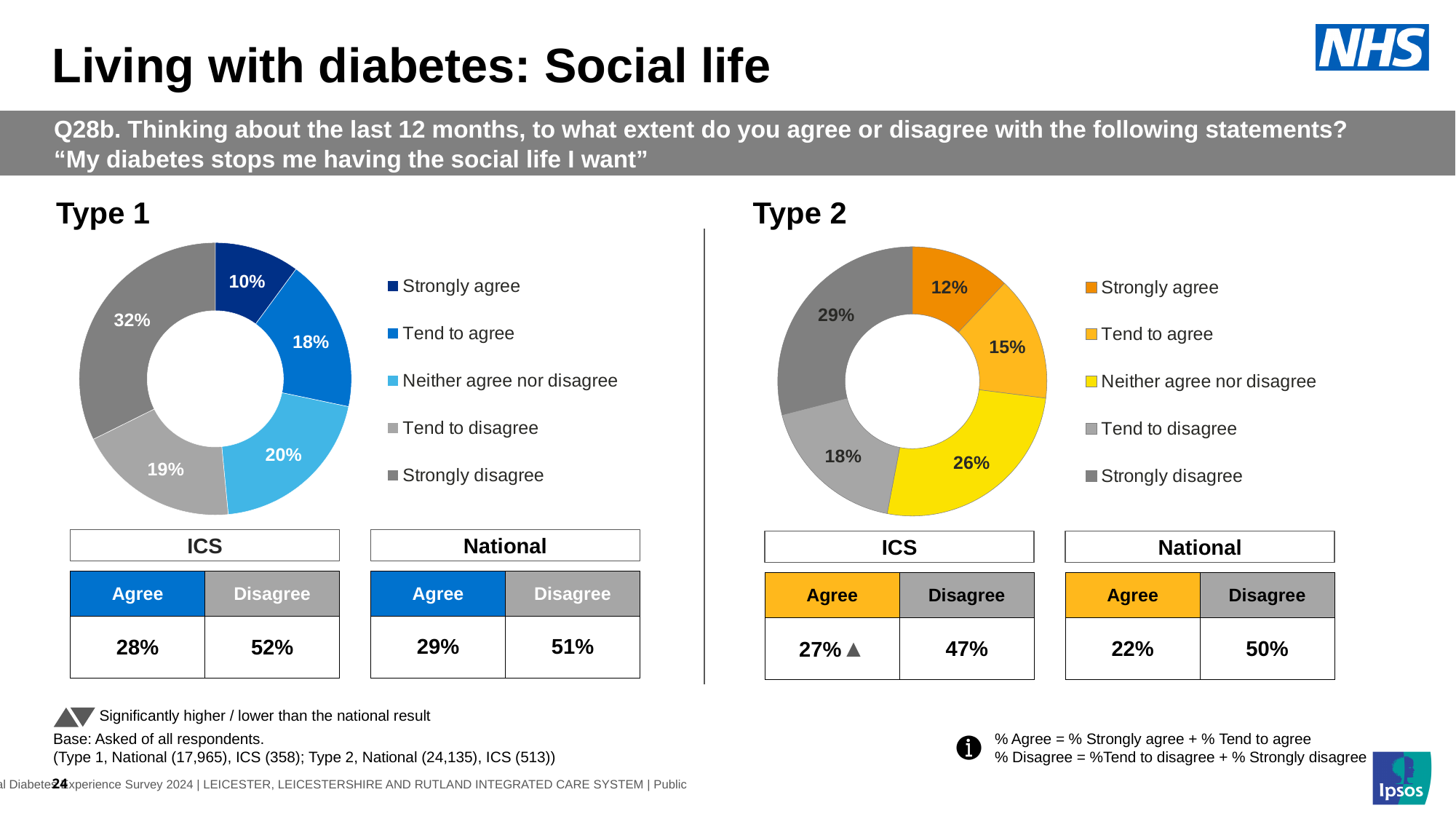
What kind of chart is used for Type 2? Donut chart In the Type 2 chart, what percentage is shown for Neither agree nor disagree? 26% In the Type 2 chart, what percentage is shown for Strongly agree? 12% In the Type 1 chart, what percentage is shown for Strongly disagree? 32% In the Type 1 chart, what is the difference between the Strongly disagree and Strongly agree percentages? 22% In the Type 2 chart, which category has the smallest share? Strongly agree In the Type 2 chart, what is the combined percentage of Strongly agree and Tend to agree? 27% In the Type 2 chart, which is larger: Tend to agree or Tend to disagree? Tend to disagree How many categories does the Type 1 chart show? 5 How many entries does the legend of the Type 1 chart list? 5 In the Type 1 chart, what percentage is shown for Tend to agree? 18% In the Type 1 chart, which category has the largest share? Strongly disagree